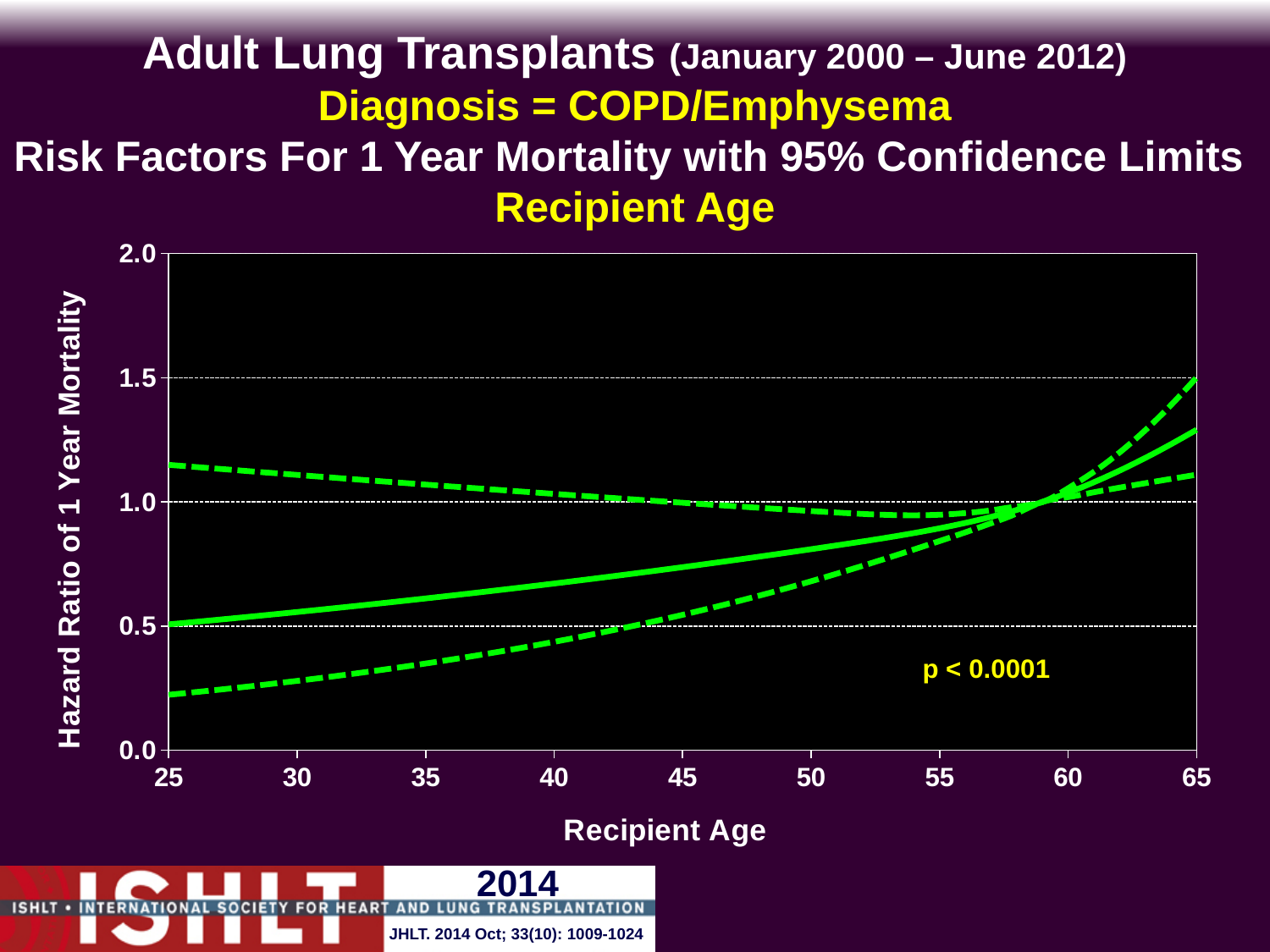
Does the solid hazard ratio line rise or fall as recipient age increases from 25 to 65? rise Is the hazard ratio (solid line) at recipient age 40 greater or less than 0.5? greater Is the lower confidence limit (lower dashed line) at recipient age 65 greater or less than 1.0? greater Is the hazard ratio (solid line) higher at recipient age 65 or at recipient age 25? 65 What p-value is printed on the chart? p < 0.0001 How many lines are plotted on the chart? 3 Is the hazard ratio (solid line) at recipient age 65 greater or less than 1.0? greater What kind of chart is shown on the slide? line chart What is the label of the y axis? Hazard Ratio of 1 Year Mortality